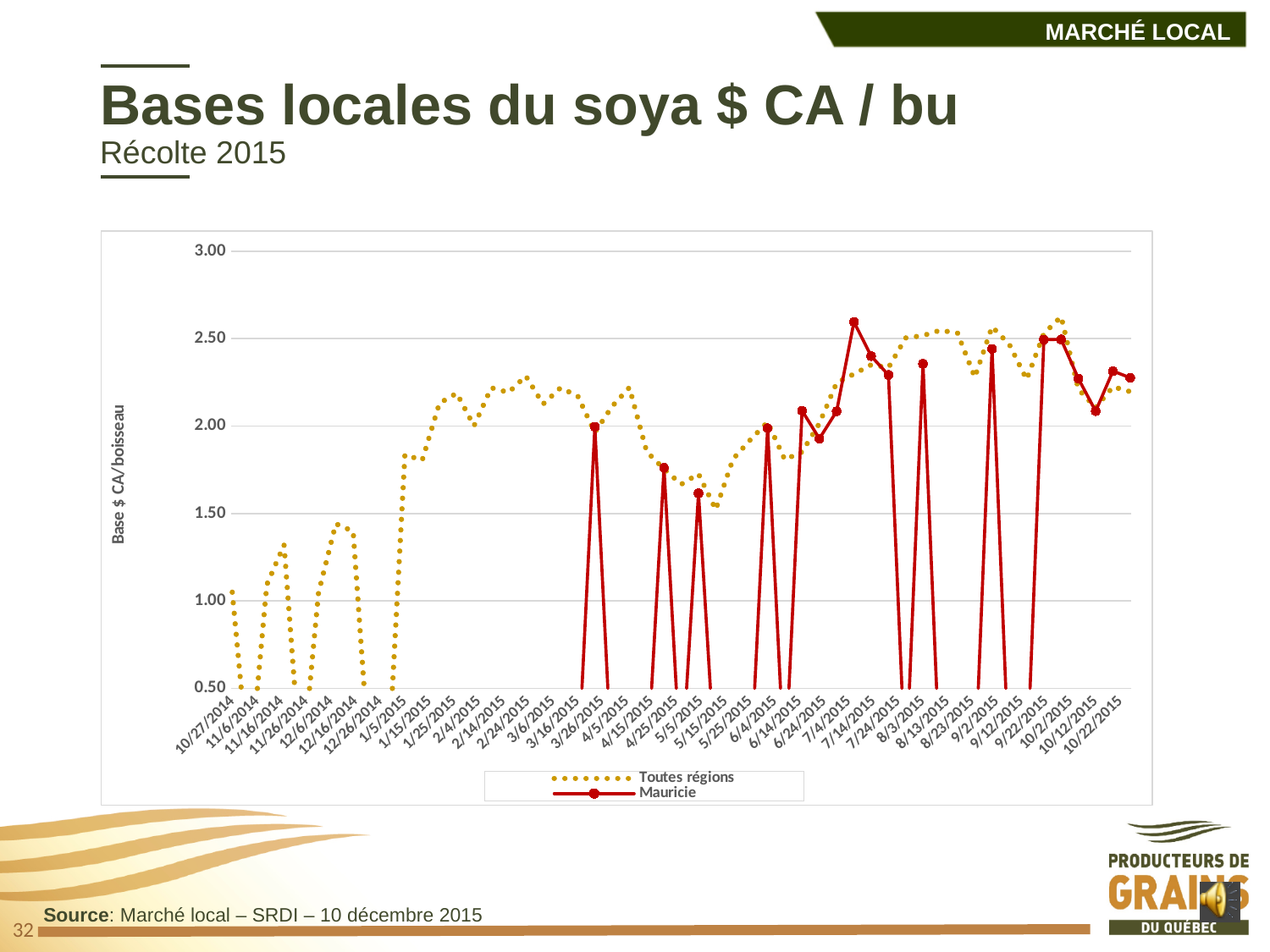
Is the Toutes régions value at 3/6/2015 greater or less than 2.00? greater Which two series are listed in the chart legend? Toutes régions and Mauricie Is the Toutes régions value at 5/15/2015 greater or less than 2.00? less Overall, does the Toutes régions series rise or fall from 10/27/2014 to 10/22/2015? rise How many series does the chart legend list? 2 What kind of chart is shown on the slide? line chart What is the lowest value shown on the vertical axis? 0.50 What is the label of the vertical axis of the chart? Base $ CA/boisseau At 7/14/2015, which series has the larger value, Mauricie or Toutes régions? Mauricie Is the Mauricie value at 7/14/2015 greater or less than 2.50? less What is the highest value shown on the vertical axis? 3.00